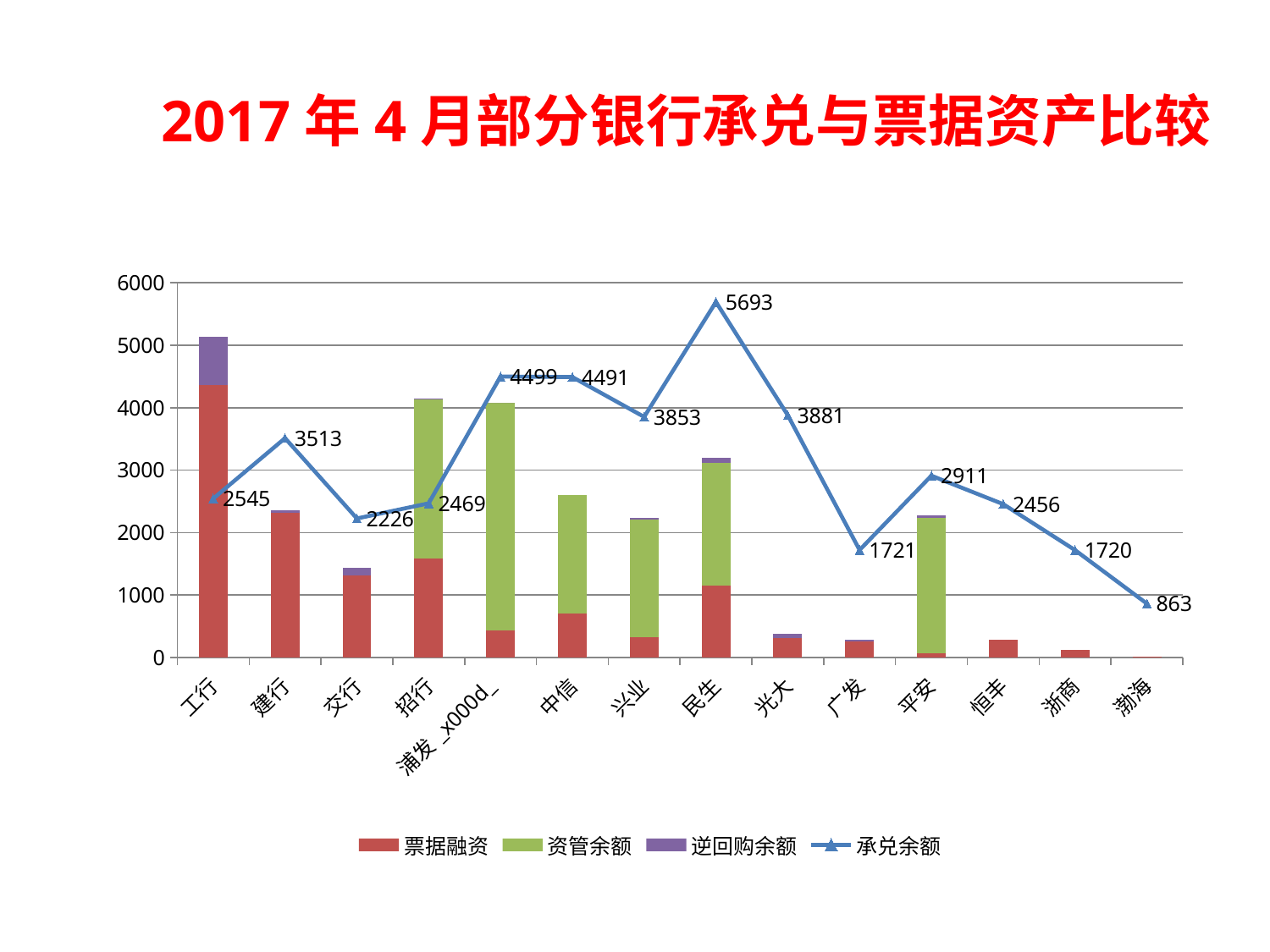
Does the 承兑余额 line rise or fall from 平安 to 渤海? fall Which bank has the lowest 承兑余额? 渤海 Is the 票据融资 value for 建行 greater or less than 3000? less Which has a larger 承兑余额, 建行 or 交行? 建行 Is the total height of the stacked bar for 工行 greater or less than 5000? greater Which bank has the highest 承兑余额? 民生 What is the difference between the 承兑余额 of 民生 and 渤海? 4830 What is the 承兑余额 value for 民生? 5693 What is the 承兑余额 value for 工行? 2545 How many series does the legend list? 4 What is the 承兑余额 value for 渤海? 863 How many banks are shown on the x axis? 14